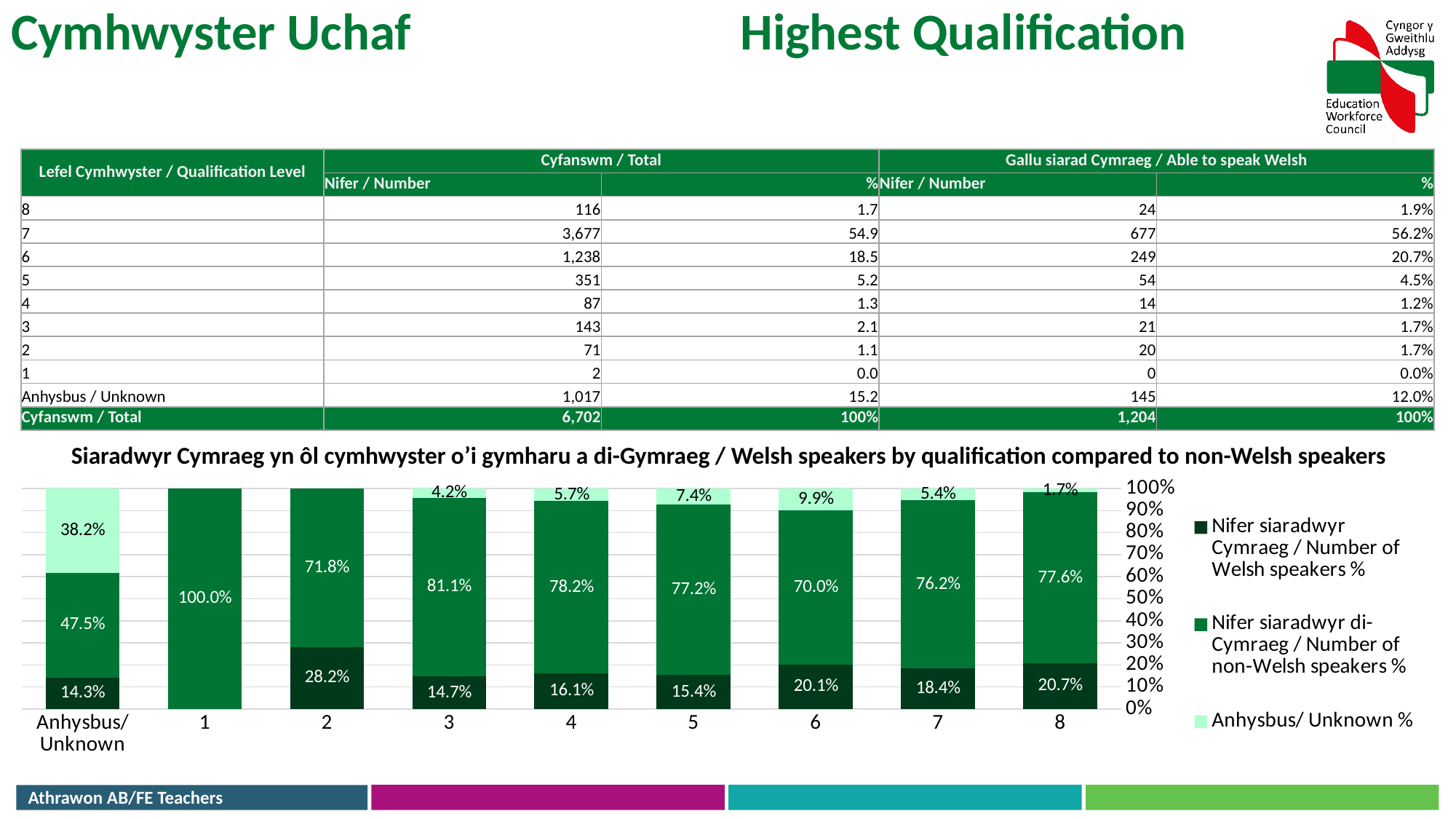
In the chart, what is the Number of Welsh speakers % for qualification level 2? 28.2% In the chart, what is the difference between the Number of non-Welsh speakers % for level 3 and level 6? 11.1 percentage points In the chart, what is the Number of Welsh speakers % for the Anhysbus/Unknown category? 14.3% How many series does the chart legend list? 3 In the chart, what is the Number of non-Welsh speakers % for qualification level 3? 81.1% In the chart, which category has the highest Number of non-Welsh speakers %? 1 In the chart, which category has the highest Number of Welsh speakers %? 2 In the chart, what is the Anhysbus/Unknown % for qualification level 6? 9.9% How many qualification categories are shown on the x axis of the chart? 9 What kind of chart is shown below the table? Stacked bar chart In the chart, is the Number of Welsh speakers % higher for level 6 or level 7? 6 In the chart, which category has the highest Anhysbus/Unknown %? Anhysbus/Unknown